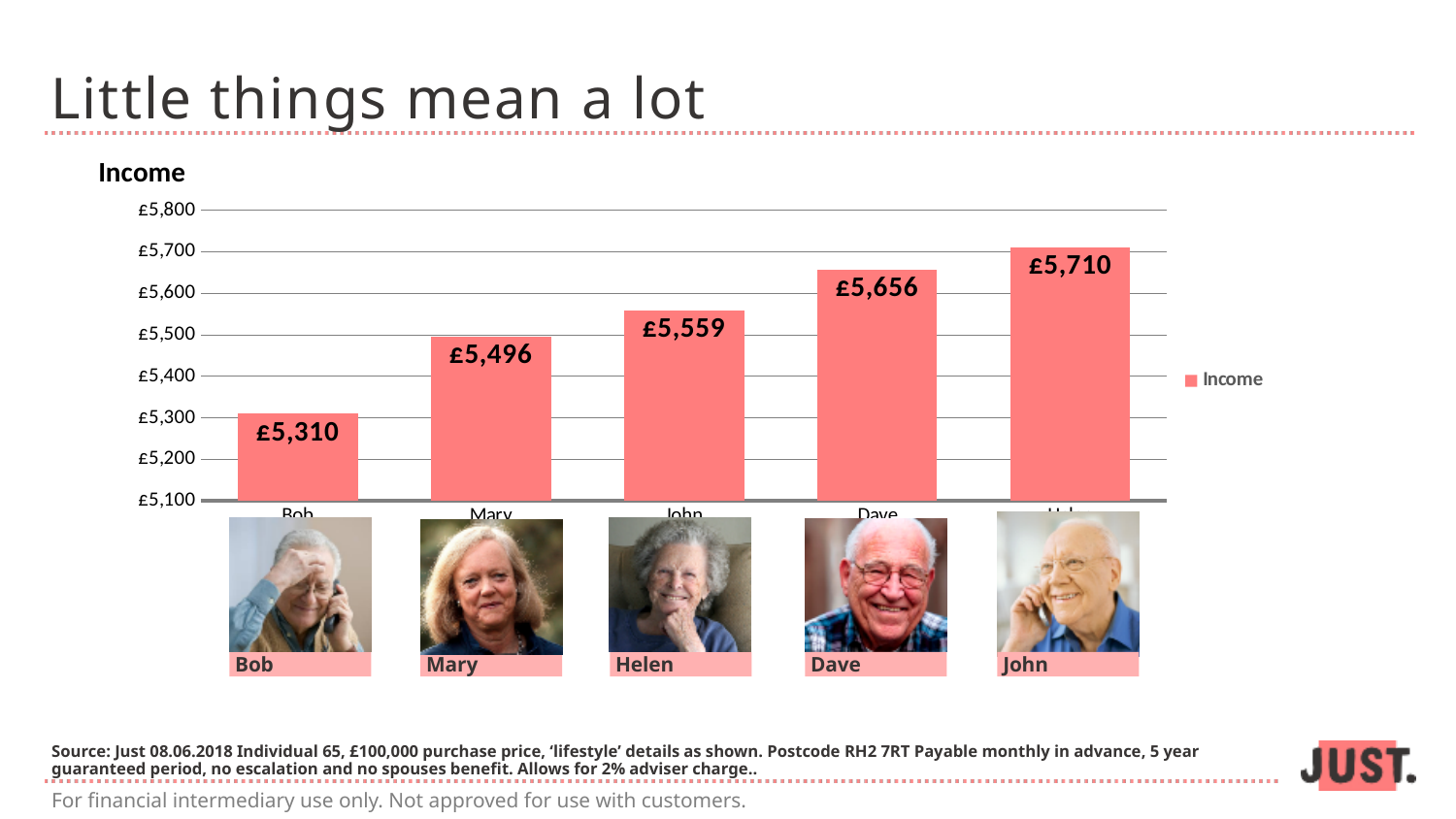
What is the income value shown for Mary? £5,496 Is the value for Bob greater or less than £5,400? less What is the income value shown for Bob? £5,310 What kind of chart is shown on the slide? bar chart Who has the larger income, Mary or Dave? Dave How many bars are plotted in the chart? 5 What is the difference between the rightmost bar's value and Bob's value? £400 Do the values rise or fall from left to right across the bars? rise Which person has the lowest income in the chart? Bob What is the value labelled on the rightmost (fifth) bar? £5,710 What is the income value shown for Dave? £5,656 What is the difference between Dave's income and Mary's income? £160